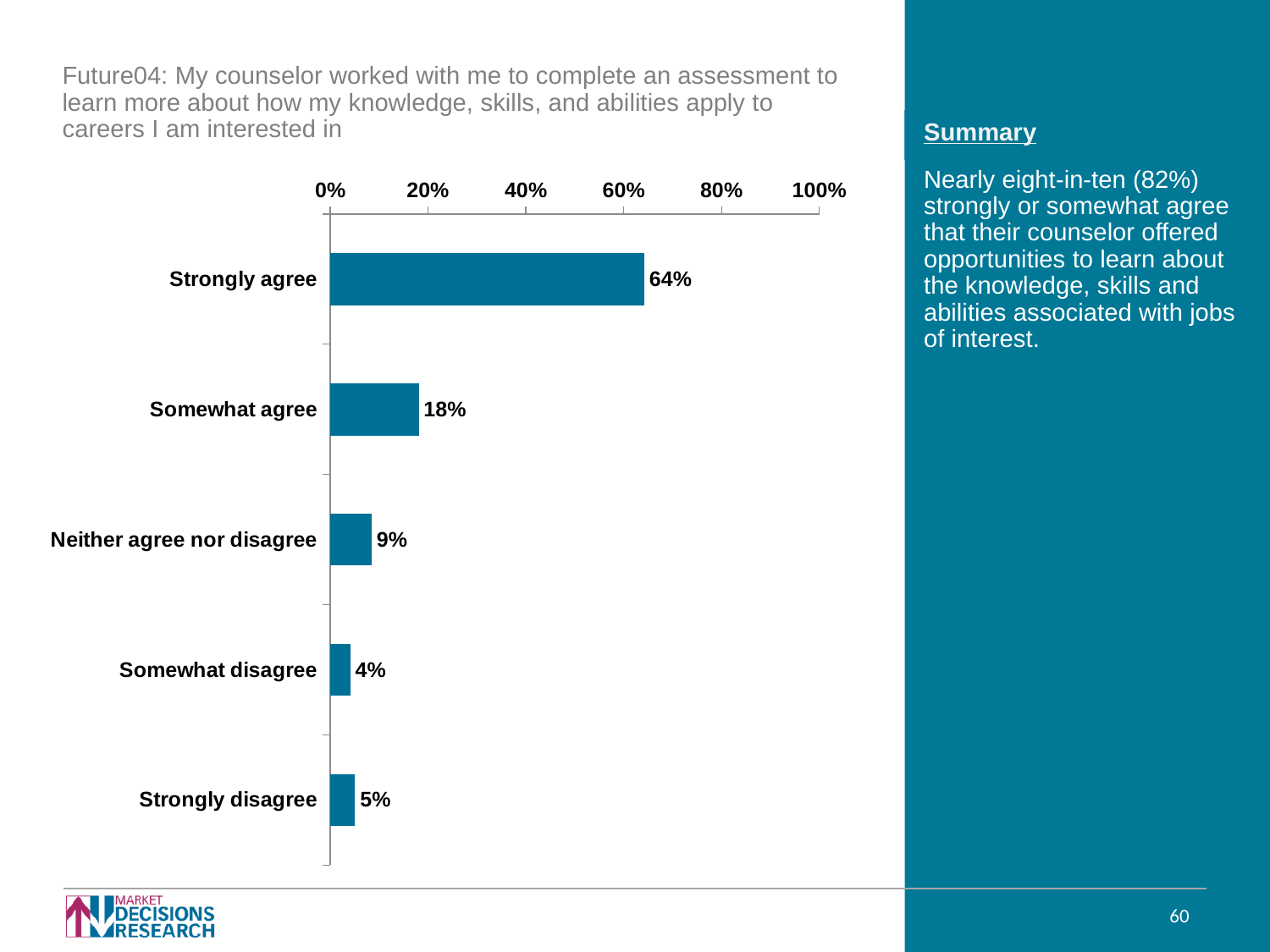
What is the maximum value shown on the percentage axis? 100% How many response categories are shown in the chart? 5 What is the value for "Strongly disagree"? 5% What percentage of respondents selected "Strongly agree"? 64% What is the value shown for "Somewhat agree"? 18% What kind of chart is shown on the slide? Bar chart Is the value for "Strongly agree" greater or less than 60%? greater Which response category has the highest value? Strongly agree What is the difference between the "Strongly agree" and "Somewhat agree" values? 46% Which is larger, the value for "Strongly disagree" or "Somewhat disagree"? Strongly disagree Which response category has the lowest value? Somewhat disagree What percentage is shown for "Neither agree nor disagree"? 9%